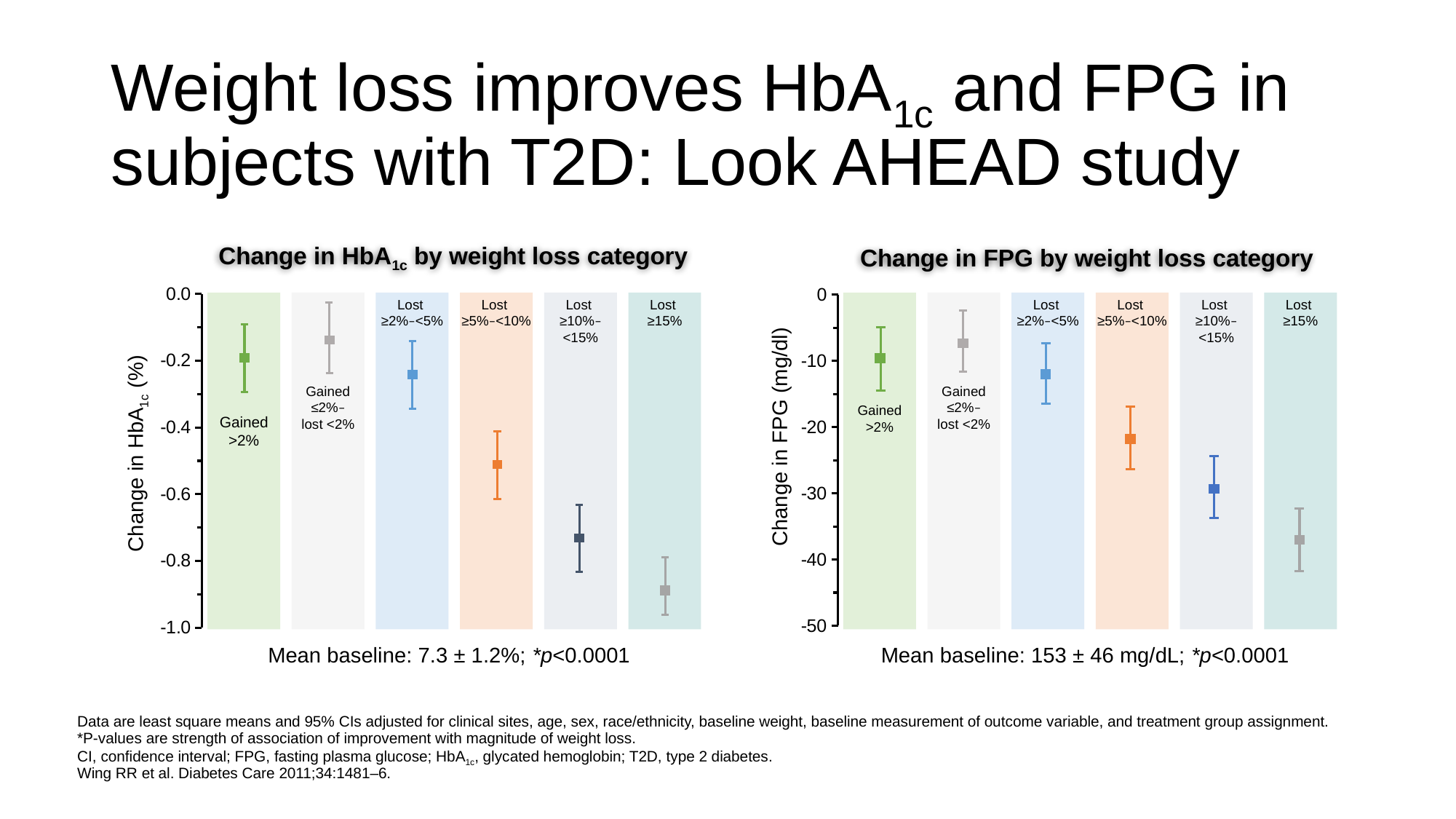
In the 'Change in HbA1c by weight loss category' chart, which category shows the largest reduction (lowest value) in HbA1c? Lost ≥15% In the 'Change in FPG by weight loss category' chart, which category has the smallest change in FPG (value closest to 0)? Gained ≤2%–lost <2% In the 'Change in FPG by weight loss category' chart, is the value for Lost ≥15% greater or less than -40? greater In the 'Change in FPG by weight loss category' chart, which category shows the largest reduction (lowest value) in FPG? Lost ≥15% In the 'Change in HbA1c by weight loss category' chart, which has the larger reduction in HbA1c: Lost ≥2%–<5% or Lost ≥10%–<15%? Lost ≥10%–<15% In the 'Change in FPG by weight loss category' chart, do the values rise or fall moving from Lost ≥2%–<5% to Lost ≥15% along the x axis? fall What kind of chart is used in the 'Change in HbA1c by weight loss category' panel? point chart with error bars (95% CIs) In the 'Change in HbA1c by weight loss category' chart, is the value for Lost ≥5%–<10% greater or less than -0.6? greater In the 'Change in FPG by weight loss category' chart, is the value for Lost ≥5%–<10% greater or less than -20? less What mean baseline value is stated below the 'Change in FPG by weight loss category' chart? 153 ± 46 mg/dL How many weight loss categories are plotted in the 'Change in HbA1c by weight loss category' chart? 6